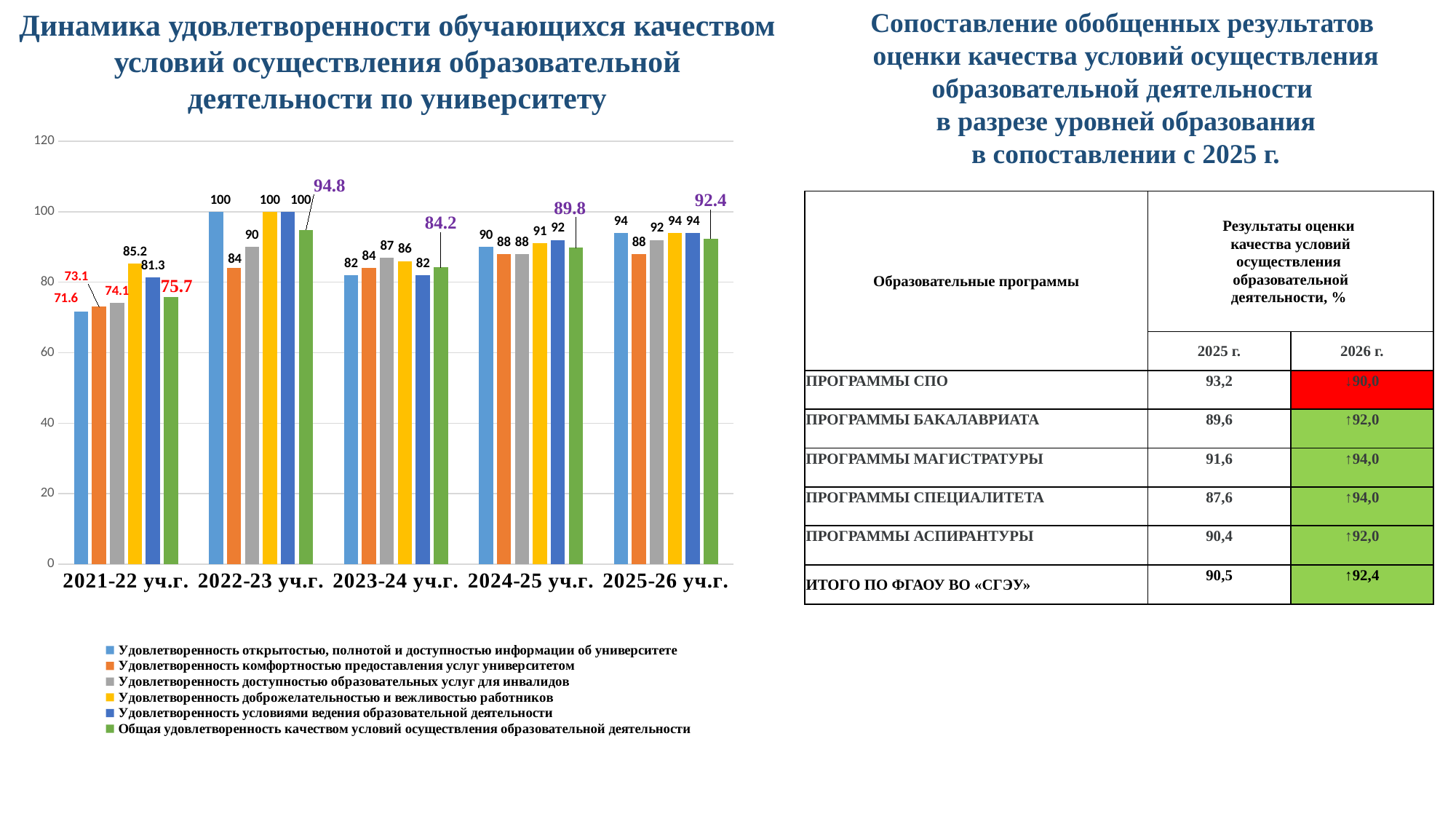
What is the value of the yellow series (Удовлетворенность доброжелательностью и вежливостью работников) for 2021-22 уч.г.? 85.2 What is the value of the green series (Общая удовлетворенность) for 2022-23 уч.г.? 94.8 How many academic years (categories) are shown on the x axis of the chart? 5 Which is larger: the gray series (Удовлетворенность доступностью образовательных услуг для инвалидов) value for 2023-24 уч.г. or for 2025-26 уч.г.? 2025-26 уч.г. What is the difference between the green series values for 2025-26 уч.г. and 2021-22 уч.г.? 16.7 Is the value of the light blue series (Удовлетворенность открытостью, полнотой и доступностью информации об университете) for 2021-22 уч.г. greater or less than 80? less In which academic year is the green series (Общая удовлетворенность) the lowest? 2021-22 уч.г. How many series does the chart legend list? 6 What is the value of the orange series (Удовлетворенность комфортностью предоставления услуг университетом) for 2025-26 уч.г.? 88 What type of chart is shown on the left side of the slide? bar chart In which academic year is the green series (Общая удовлетворенность) the highest? 2022-23 уч.г. What is the value of the green series (Общая удовлетворенность качеством условий осуществления образовательной деятельности) for 2021-22 уч.г.? 75.7